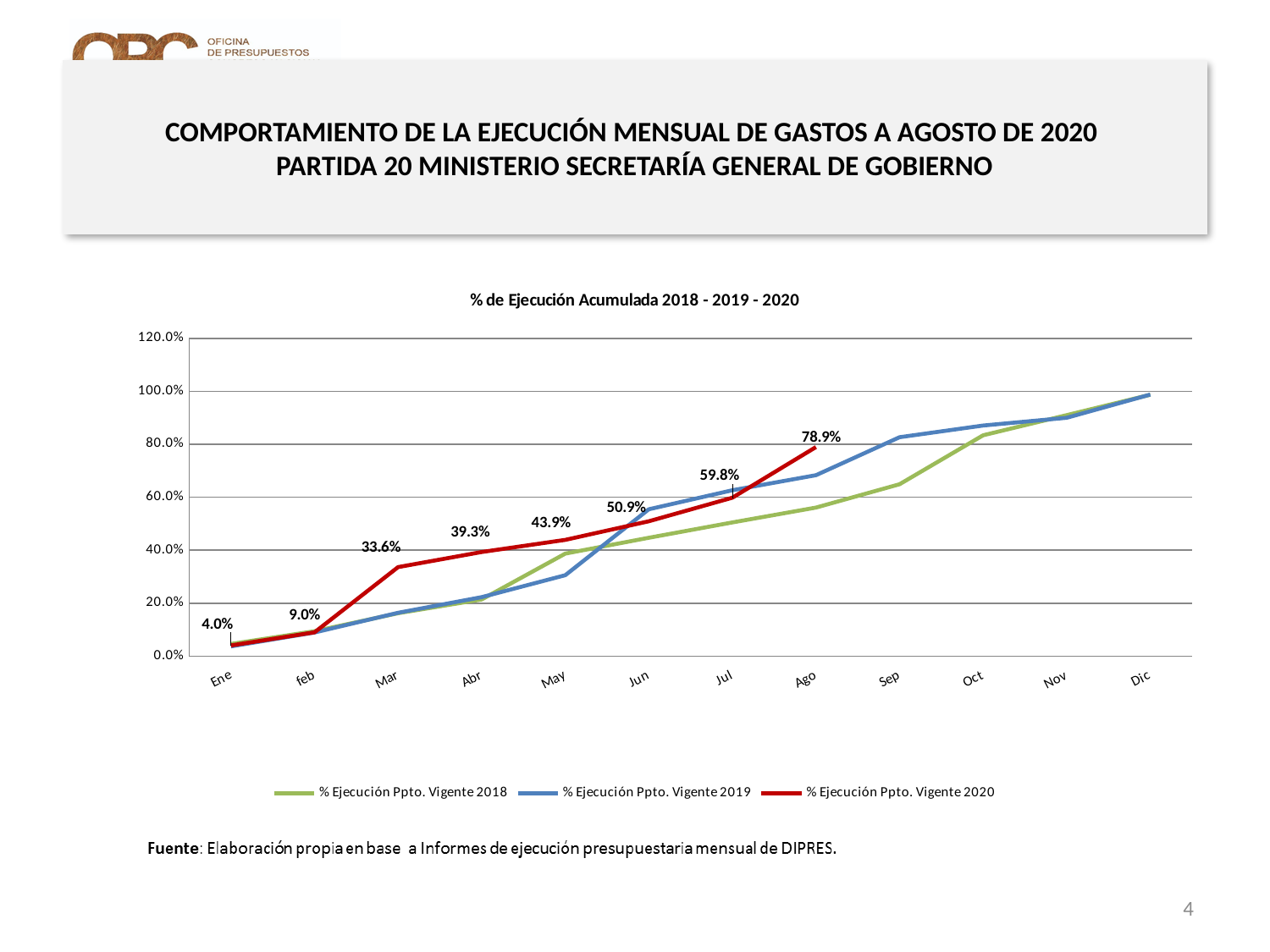
How many series does the legend list? 3 Does the % Ejecución Ppto. Vigente 2020 series rise or fall from Ene to Ago? rise Is the value of % Ejecución Ppto. Vigente 2019 for Sep greater or less than 60.0%? greater How many months are shown on the x axis? 12 What is the value of % Ejecución Ppto. Vigente 2020 for Jun? 50.9% What is the difference between the % Ejecución Ppto. Vigente 2020 values for Mar and Feb? 24.6% What is the value of % Ejecución Ppto. Vigente 2020 for Mar? 33.6% What kind of chart is shown on the slide? line chart What is the difference between the % Ejecución Ppto. Vigente 2020 values for Ago and Jul? 19.1% What is the value of % Ejecución Ppto. Vigente 2020 for Ene? 4.0% What is the title of the chart? % de Ejecución Acumulada 2018 - 2019 - 2020 What is the value of % Ejecución Ppto. Vigente 2020 for Ago? 78.9%